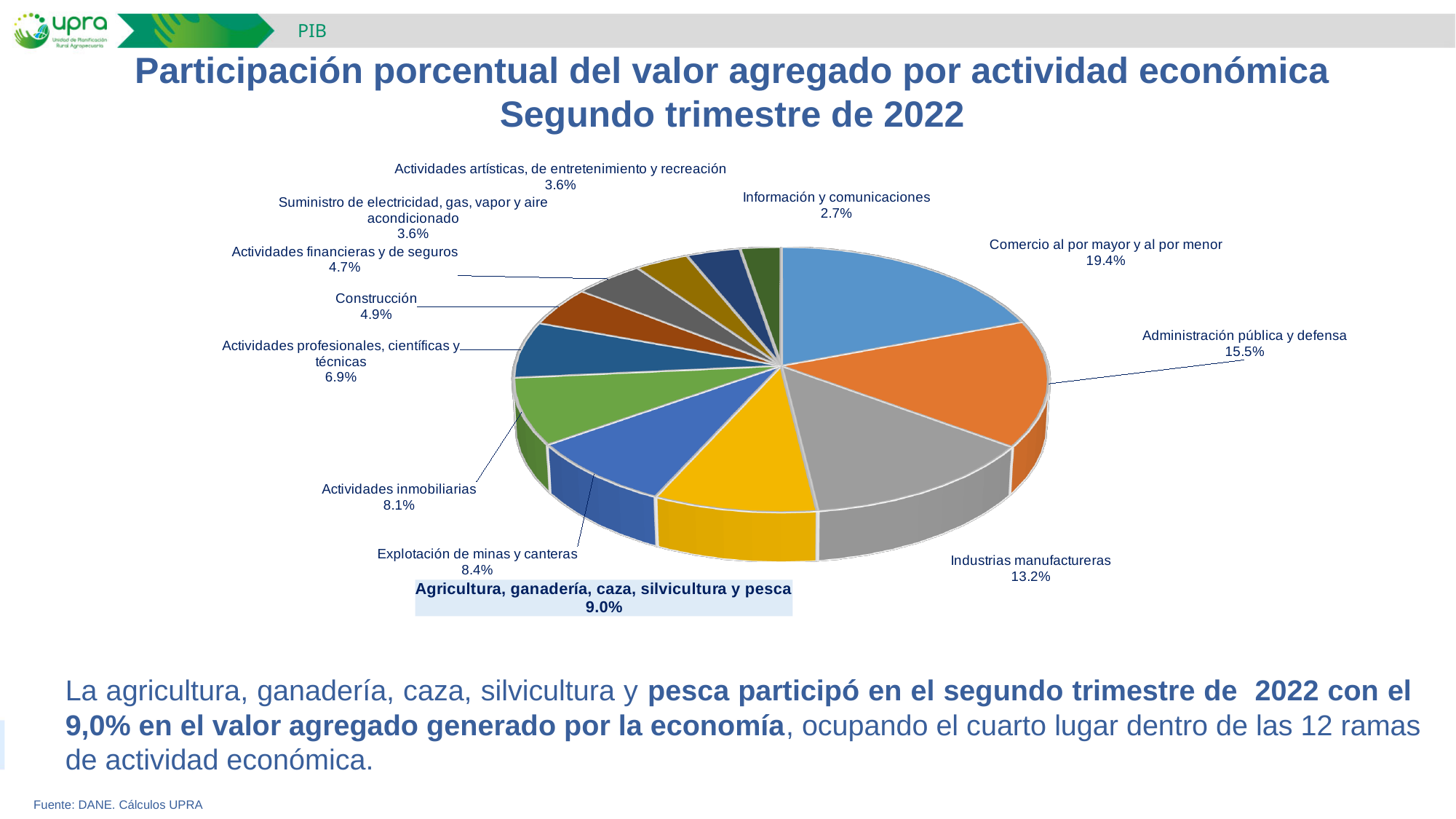
What is the share of Comercio al por mayor y al por menor in the pie chart? 19.4% Which has a larger share: Explotación de minas y canteras or Actividades inmobiliarias? Explotación de minas y canteras What is the share of Construcción in the pie chart? 4.9% What kind of chart is shown on the slide? Pie chart Which economic activity has the largest share in the pie chart? Comercio al por mayor y al por menor What is the value shown for Industrias manufactureras? 13.2% What percentage does Agricultura, ganadería, caza, silvicultura y pesca represent in the pie chart? 9.0% How many economic activities (slices) are shown in the pie chart? 12 What is the difference in percentage points between Actividades profesionales, científicas y técnicas and Actividades financieras y de seguros? 2.2 percentage points What is the difference in percentage points between Comercio al por mayor y al por menor and Administración pública y defensa? 3.9 percentage points Which economic activity has the smallest share in the pie chart? Información y comunicaciones What is the title of the chart on the slide? Participación porcentual del valor agregado por actividad económica Segundo trimestre de 2022